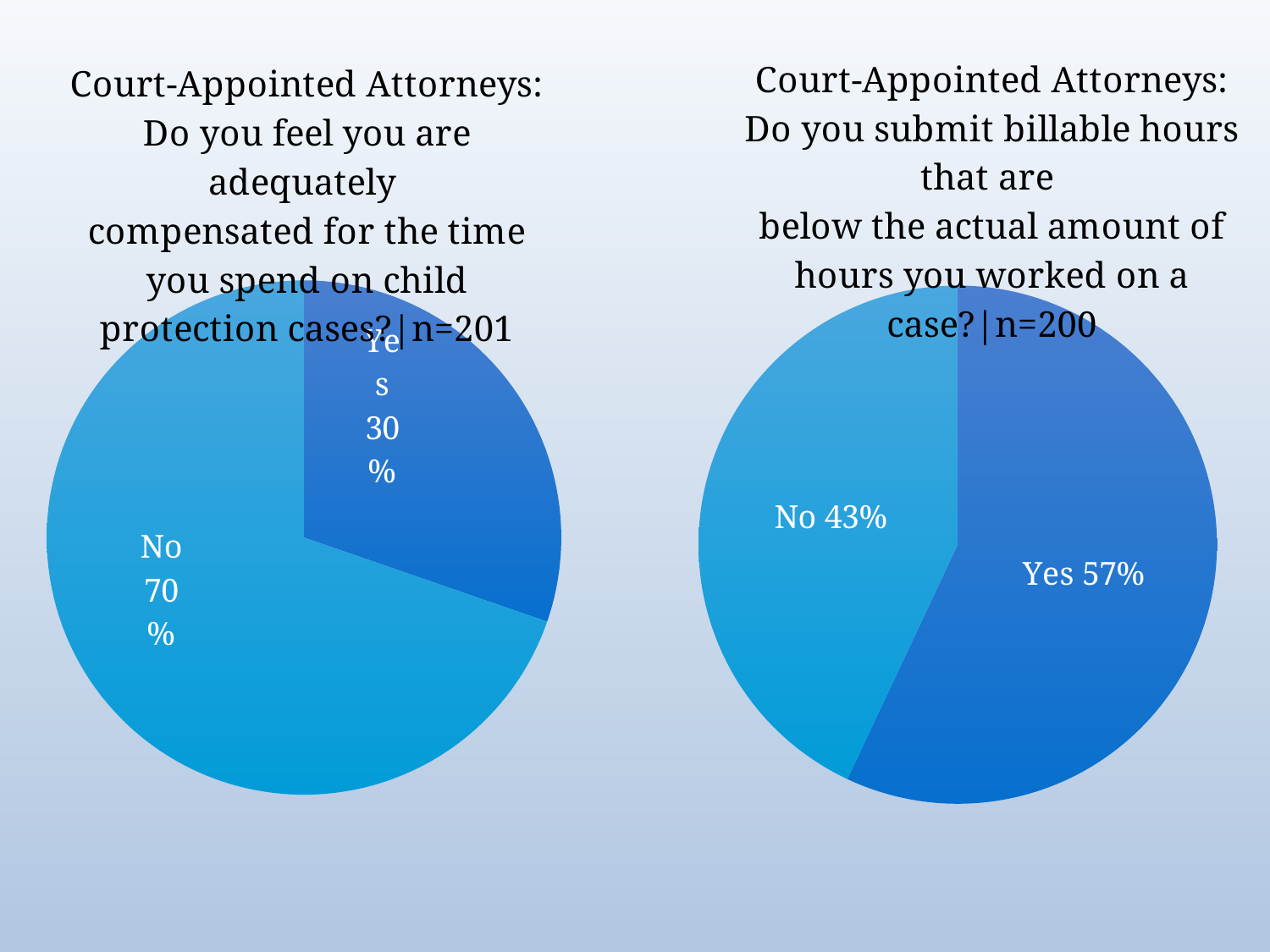
What is the sample size (n) shown in the title of the left pie chart? n=201 In the left pie chart (adequately compensated), what is the difference in percentage points between No and Yes? 40 In the right pie chart (billable hours below actual), what percentage answered Yes? 57% In the left pie chart (adequately compensated), what percentage answered Yes? 30% In the right pie chart (billable hours below actual), which response has the smallest share? No In the right pie chart (billable hours below actual), which is larger, Yes or No? Yes In the left pie chart (adequately compensated), which response has the largest share? No In the left pie chart (adequately compensated), what percentage answered No? 70% What type of chart is used on the left side of the slide? Pie chart In the right pie chart (billable hours below actual), what is the difference in percentage points between Yes and No? 14 How many slices does the right pie chart (billable hours below actual) have? 2 In the right pie chart (billable hours below actual), what percentage answered No? 43%